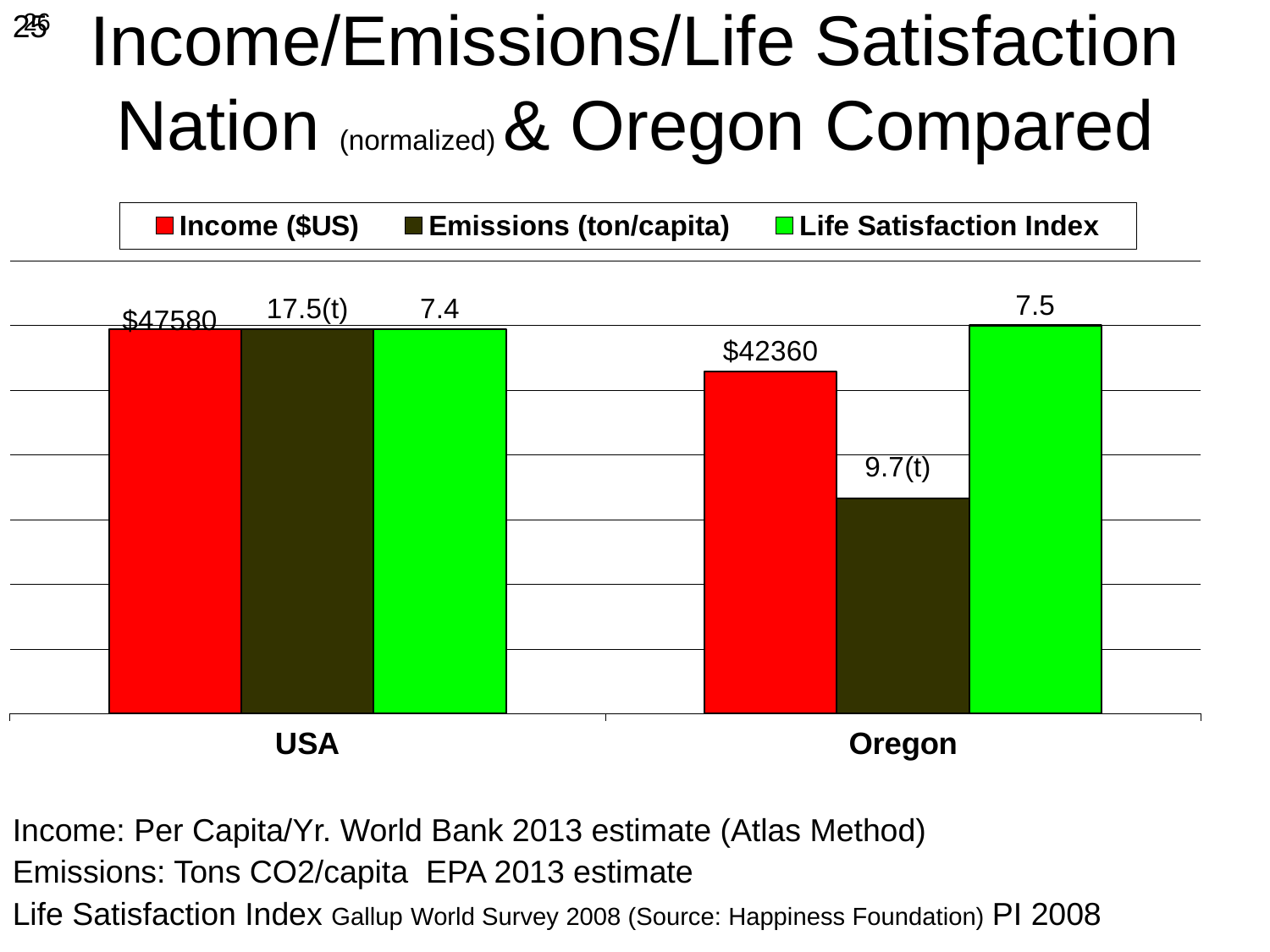
Which category has the higher Income ($US) value? USA How many series does the legend list? 3 What is the Income ($US) value for USA? $47580 What is the Emissions (ton/capita) value for USA? 17.5(t) How many categories are shown on the x axis? 2 What is the Life Satisfaction Index value for Oregon? 7.5 What is the Income ($US) value for Oregon? $42360 Is the Life Satisfaction Index higher for USA or Oregon? Oregon What is the difference in Emissions (ton/capita) between USA and Oregon? 7.8 What is the Emissions (ton/capita) value for Oregon? 9.7(t) Which category has the lower Emissions (ton/capita) value? Oregon What kind of chart is shown on the slide? Bar chart